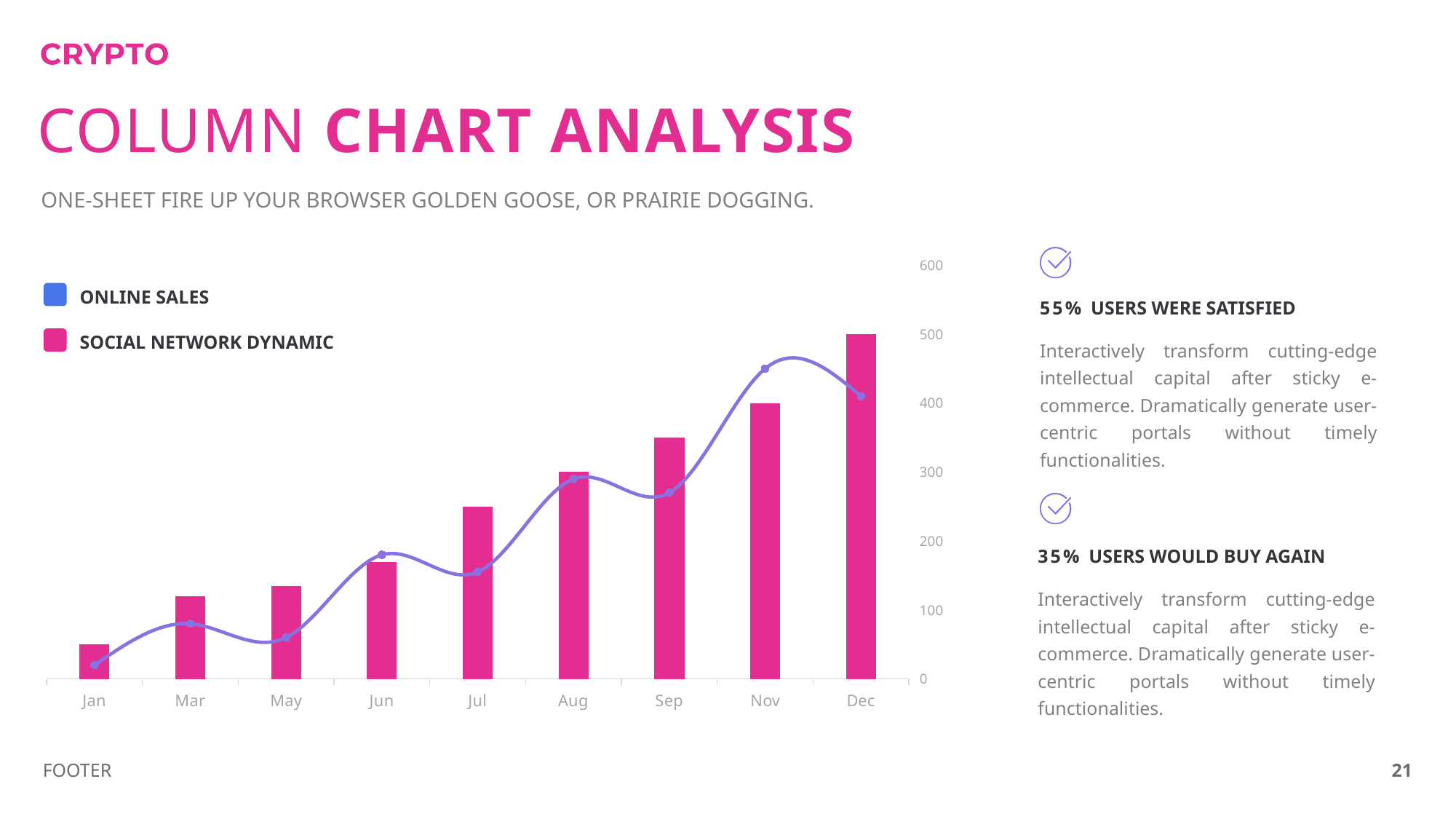
Which month has the tallest Social Network Dynamic bar? Dec Is the Social Network Dynamic value for Sep greater or less than 300? greater Is the Social Network Dynamic value for Jul greater or less than 200? greater What kind of chart is shown on the slide? A bar chart combined with a line How many months are shown on the x axis of the chart? 9 Is the Social Network Dynamic value for Jan greater or less than 100? less How many series does the chart legend list? 2 Which series is shown in pink in the legend? Social Network Dynamic Which is larger, the Social Network Dynamic bar for Mar or for Aug? Aug Do the Social Network Dynamic bars generally rise or fall from Jan to Dec? rise Which month has the shortest Social Network Dynamic bar? Jan In which month does the Online Sales line reach its highest point? Nov